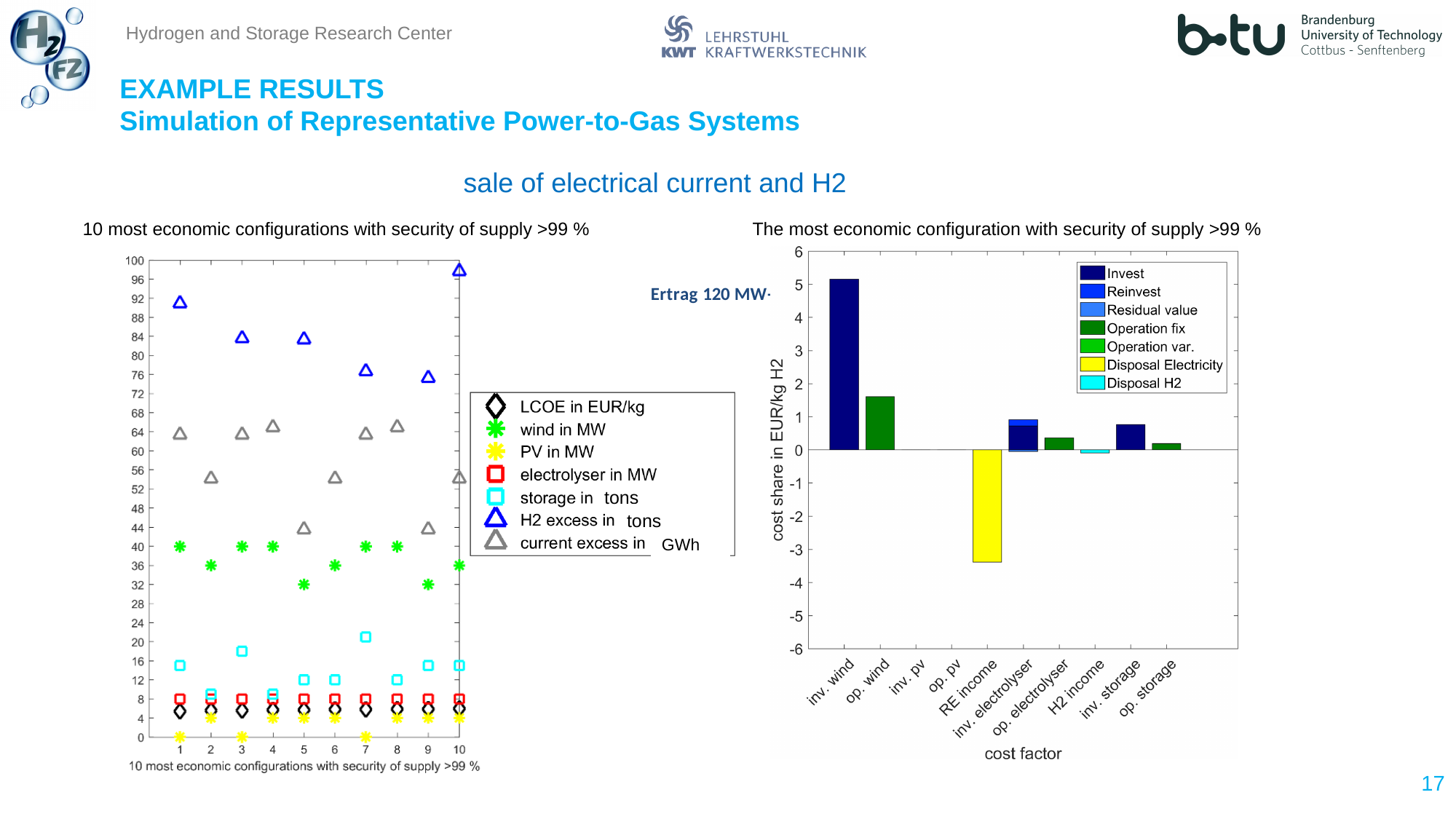
On the right chart, is the cost share for inv. wind greater or less than 5? greater On the left chart, '10 most economic configurations with security of supply >99 %', how many configurations are plotted on the x axis? 10 On the right chart, what is the label of the y axis? cost share in EUR/kg H2 On the right chart, which has the larger cost share, op. wind or op. electrolyser? op. wind On the right chart, is the cost share for RE income greater or less than -3? less On the right chart, which cost factor has the lowest (most negative) cost share? RE income On the right chart, how many entries does the legend list? 7 On the right chart, which cost factor has the highest cost share? inv. wind On the right chart, how many cost factor categories are shown on the x axis? 10 On the right chart, 'The most economic configuration with security of supply >99 %', what kind of chart is it? bar chart On the left chart, how many series does the legend list? 7 On the left chart, which series has the highest value at configuration 10? H2 excess in tons